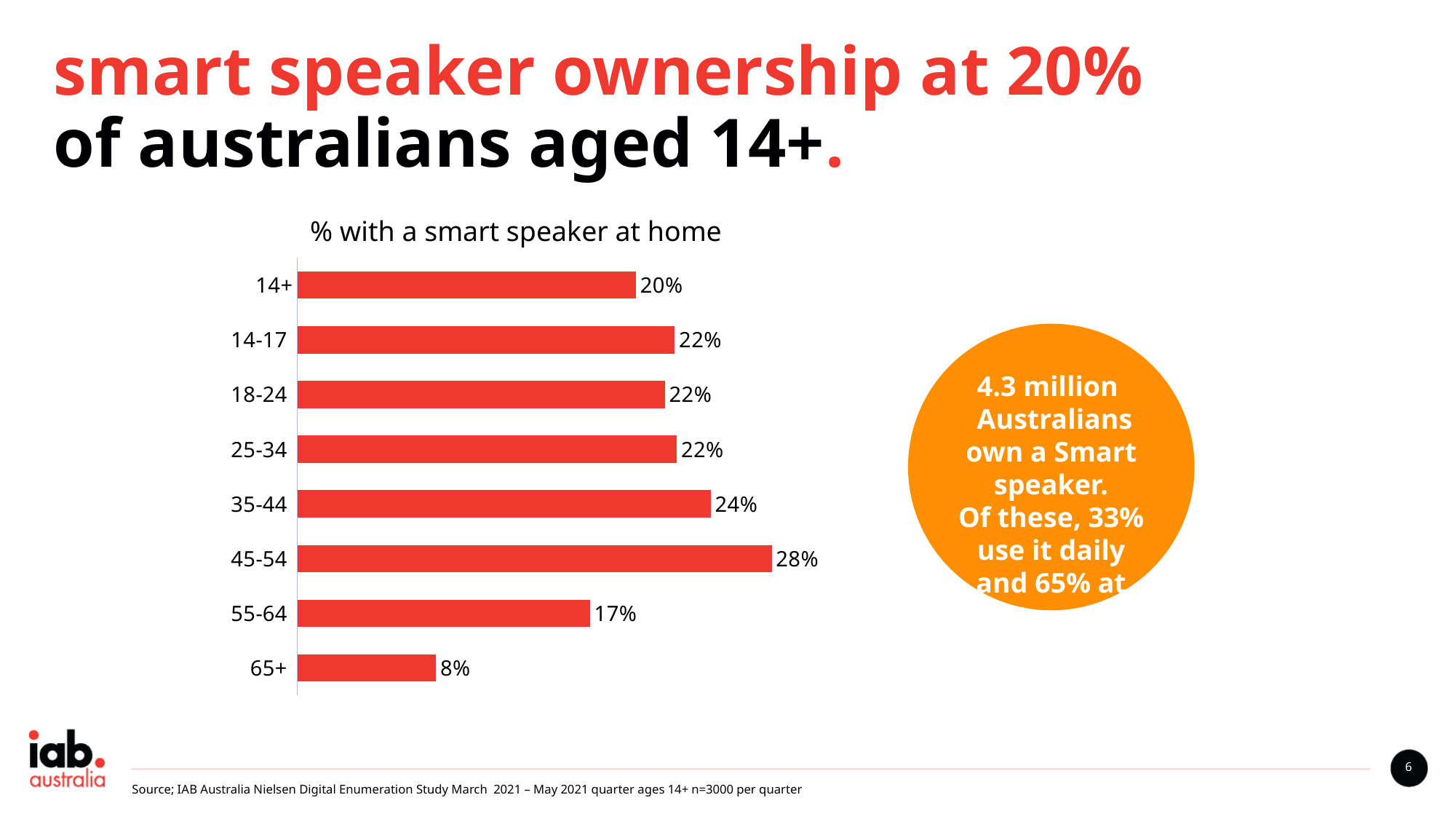
What is the value for the 55-64 age group? 17% What is the title of the chart? % with a smart speaker at home What kind of chart is shown on the slide? Bar chart Which age group has the highest percentage with a smart speaker at home? 45-54 What is the value for the 45-54 age group? 28% Which age group has the lowest percentage with a smart speaker at home? 65+ What is the value for the 65+ age group? 8% What is the value for the 35-44 age group? 24% Which is larger, the value for 14+ or the value for 35-44? 35-44 How many age categories are shown in the chart? 8 What is the difference between the values for 35-44 and 55-64? 7% What is the difference between the values for 45-54 and 65+? 20%